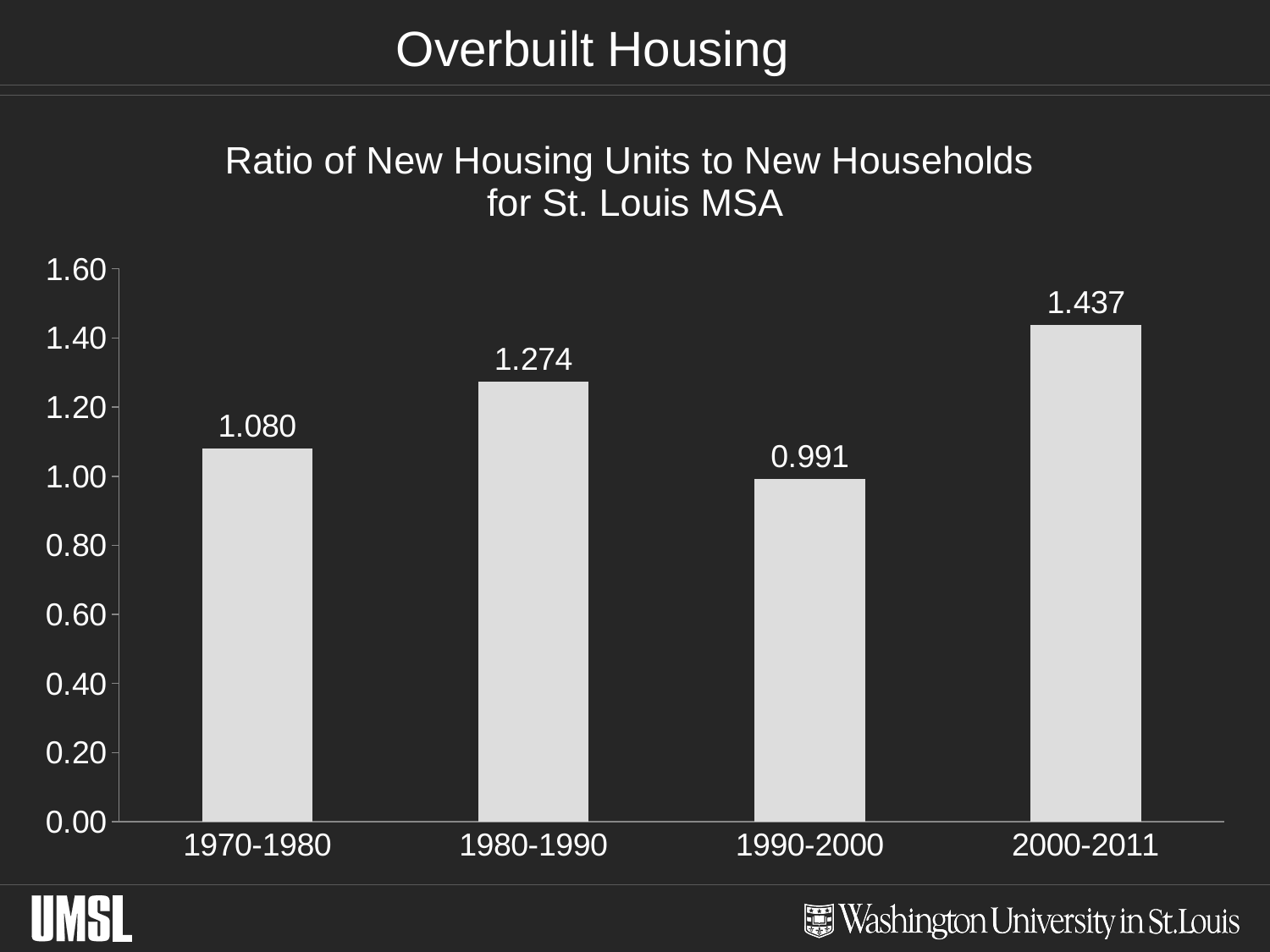
What kind of chart is shown on the slide? Bar chart What is the title of the chart? Ratio of New Housing Units to New Households for St. Louis MSA What is the difference between the ratio for 1980-1990 and the ratio for 1970-1980? 0.194 What is the ratio of new housing units to new households for 1970-1980? 1.080 Which period has the lowest ratio of new housing units to new households? 1990-2000 What is the ratio of new housing units to new households for 2000-2011? 1.437 Is the value for 1990-2000 greater or less than 1.00? less Which period has a larger ratio, 1980-1990 or 1970-1980? 1980-1990 What is the ratio of new housing units to new households for 1990-2000? 0.991 Which period has the highest ratio of new housing units to new households? 2000-2011 How many periods are shown on the x axis of the chart? 4 What is the difference between the ratio for 2000-2011 and the ratio for 1990-2000? 0.446